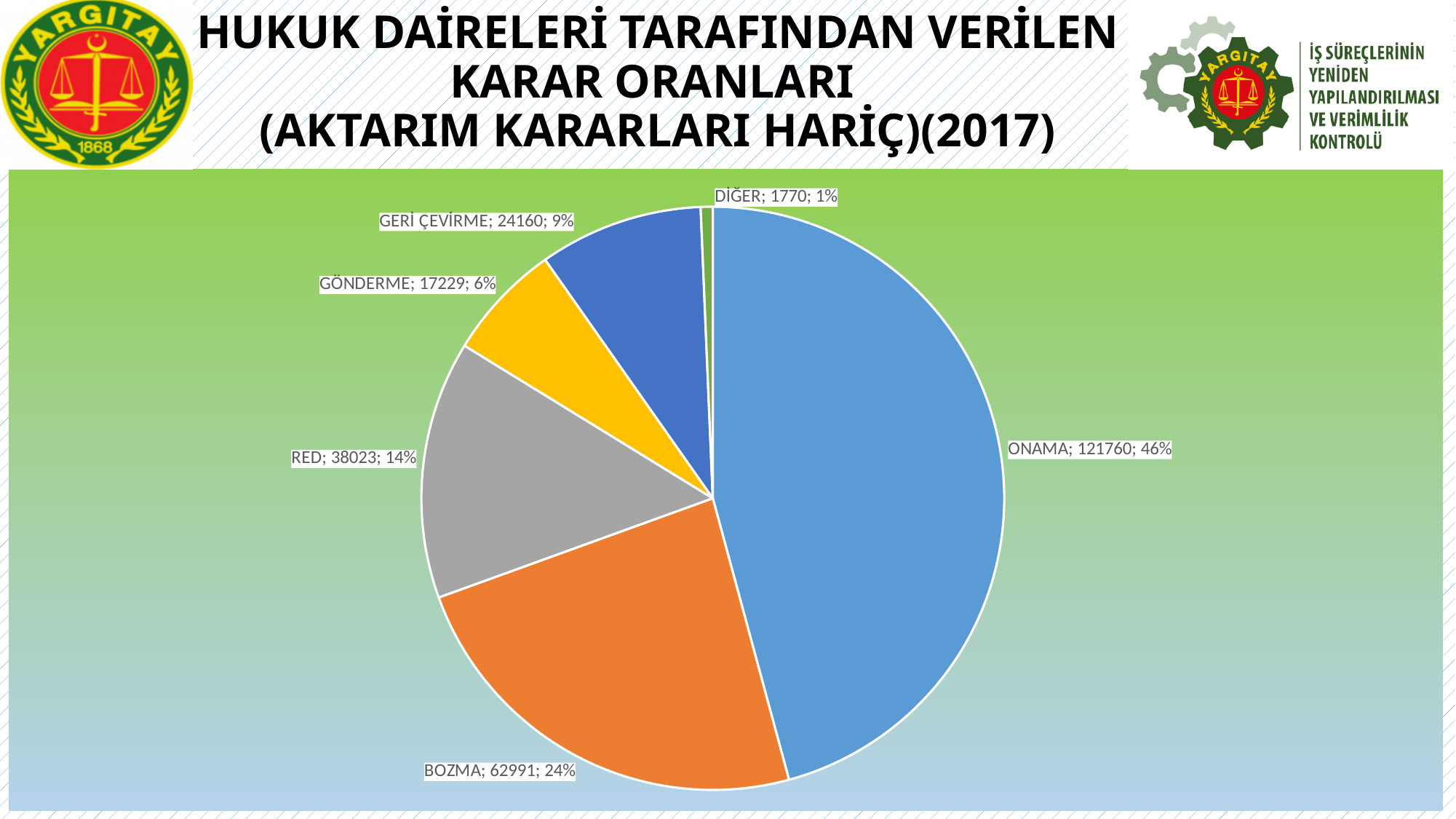
Which category has the smallest slice? DİĞER What percentage share does RED have? 14% What percentage share does GÖNDERME have? 6% What kind of chart is shown on the slide? pie chart What is the value for ONAMA? 121760 How many slices does the pie chart have? 6 What is the value for GERİ ÇEVİRME? 24160 What is the value for BOZMA? 62991 Which is larger, the value for RED or the value for GERİ ÇEVİRME? RED What is the difference between the values for ONAMA and BOZMA? 58769 Which category has the largest slice? ONAMA What year is given in the chart title? 2017